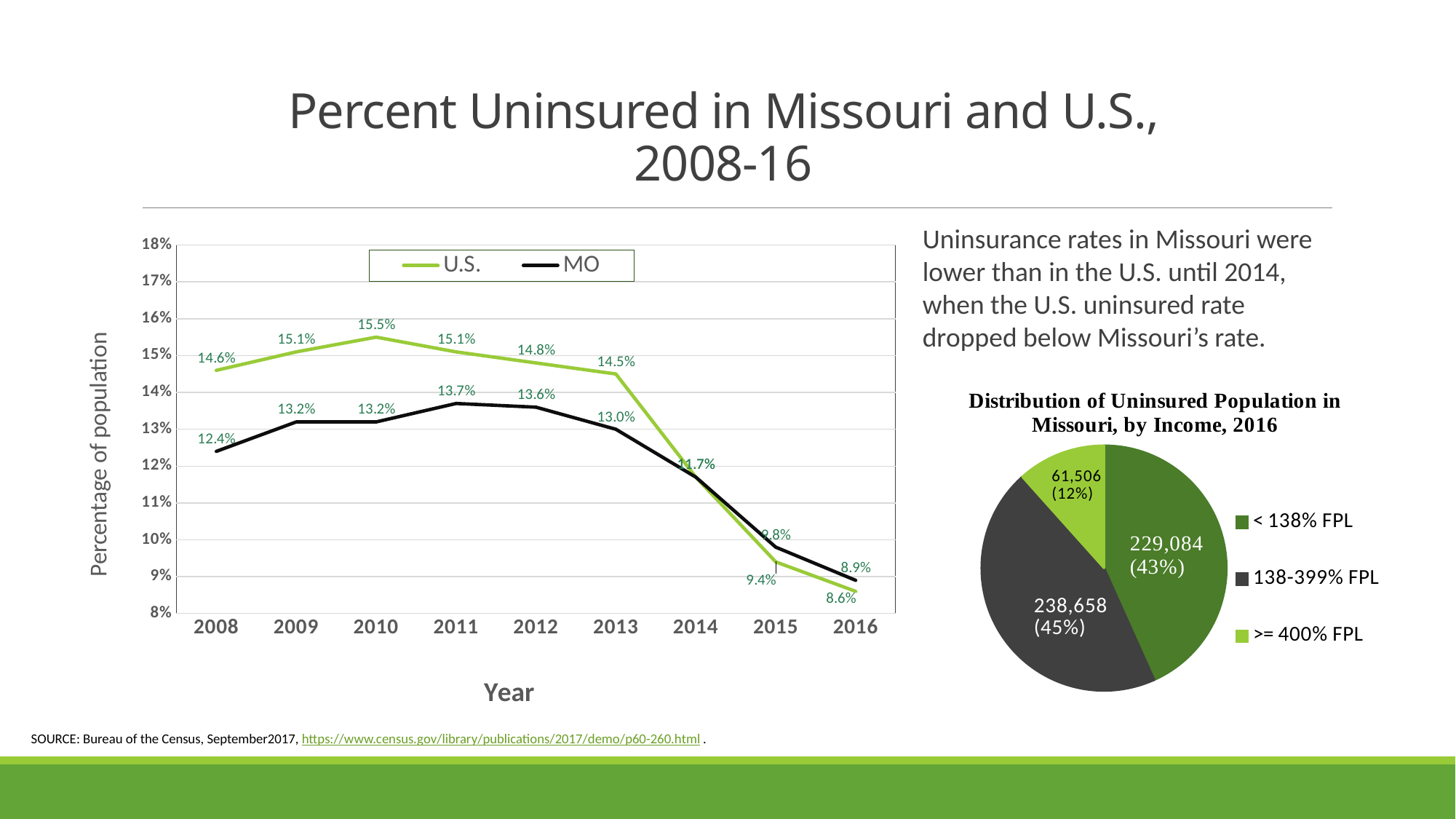
In the line chart 'Percent Uninsured in Missouri and U.S., 2008-16', what is the difference between the U.S. and MO rates in 2008? 2.2% In the line chart 'Percent Uninsured in Missouri and U.S., 2008-16', what was the MO uninsured rate in 2008? 12.4% In the line chart 'Percent Uninsured in Missouri and U.S., 2008-16', does the U.S. series rise or fall from 2013 to 2016? fall In the line chart 'Percent Uninsured in Missouri and U.S., 2008-16', what was the U.S. uninsured rate in 2010? 15.5% In the pie chart 'Distribution of Uninsured Population in Missouri, by Income, 2016', what is the value for the 138-399% FPL slice? 238,658 (45%) What kind of chart is the chart on the right of the slide? pie chart In the line chart 'Percent Uninsured in Missouri and U.S., 2008-16', how many years are shown on the x axis? 9 In the line chart 'Percent Uninsured in Missouri and U.S., 2008-16', what was the MO uninsured rate in 2016? 8.9% In the line chart 'Percent Uninsured in Missouri and U.S., 2008-16', how many series does the legend list? 2 In the pie chart 'Distribution of Uninsured Population in Missouri, by Income, 2016', what share of the pie is the >= 400% FPL slice? 12% In the line chart 'Percent Uninsured in Missouri and U.S., 2008-16', in which year did the U.S. series reach its highest value? 2010 In the line chart 'Percent Uninsured in Missouri and U.S., 2008-16', which series had the higher value in 2016, U.S. or MO? MO